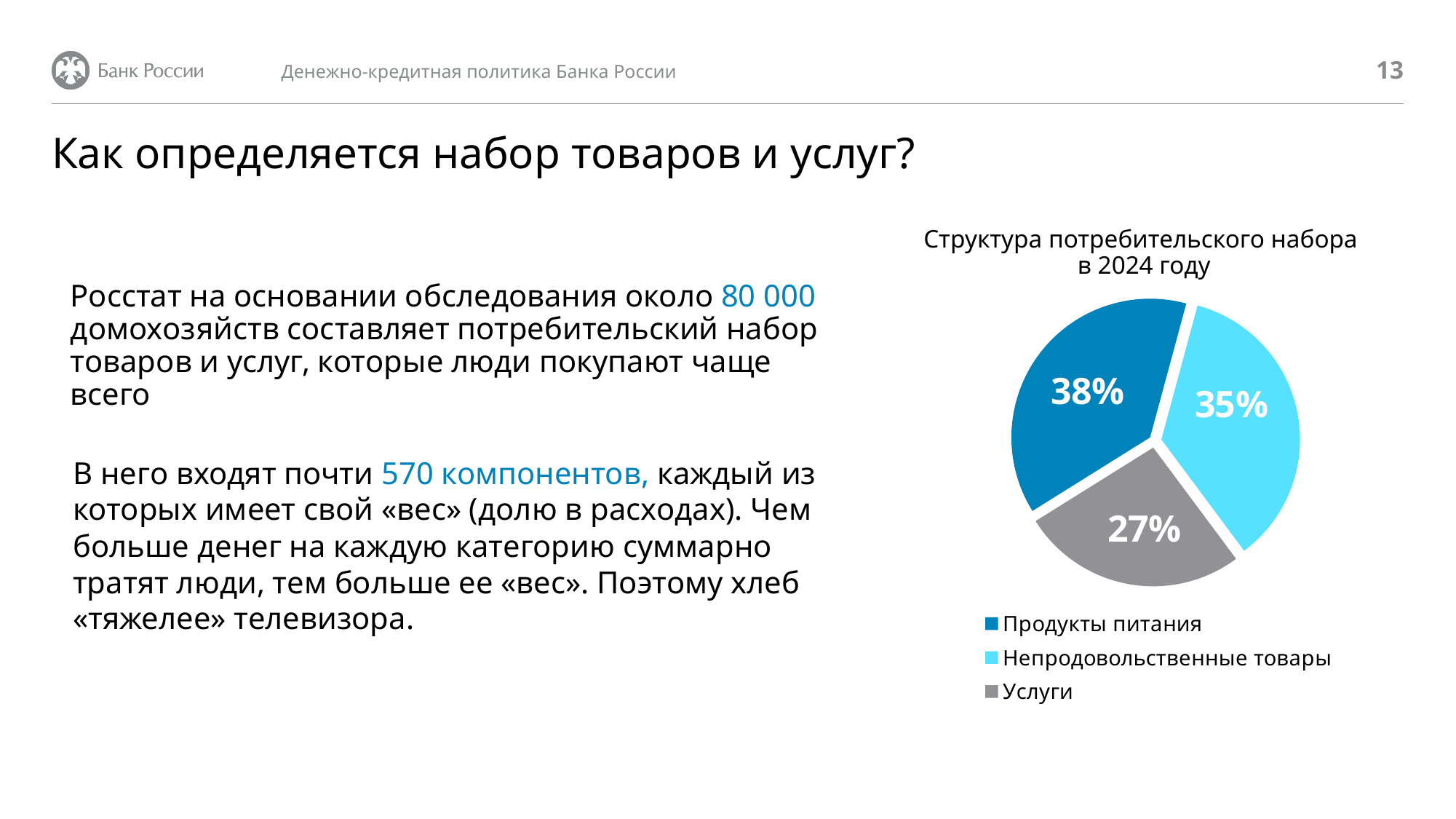
Which category has the smallest share of the consumer basket? Услуги What is the title of the chart? Структура потребительского набора в 2024 году What is the difference in percentage points between the share of Непродовольственные товары and the share of Услуги? 8 Which colour represents Услуги in the pie chart? Grey Which category has the largest share of the consumer basket? Продукты питания What kind of chart is shown on the slide? Pie chart What share of the consumer basket is Непродовольственные товары? 35% How many categories does the pie chart show? 3 What is the difference in percentage points between the share of Продукты питания and the share of Услуги? 11 Which is larger: the share of Непродовольственные товары or the share of Услуги? Непродовольственные товары What share of the consumer basket is Продукты питания? 38% What share of the consumer basket is Услуги? 27%